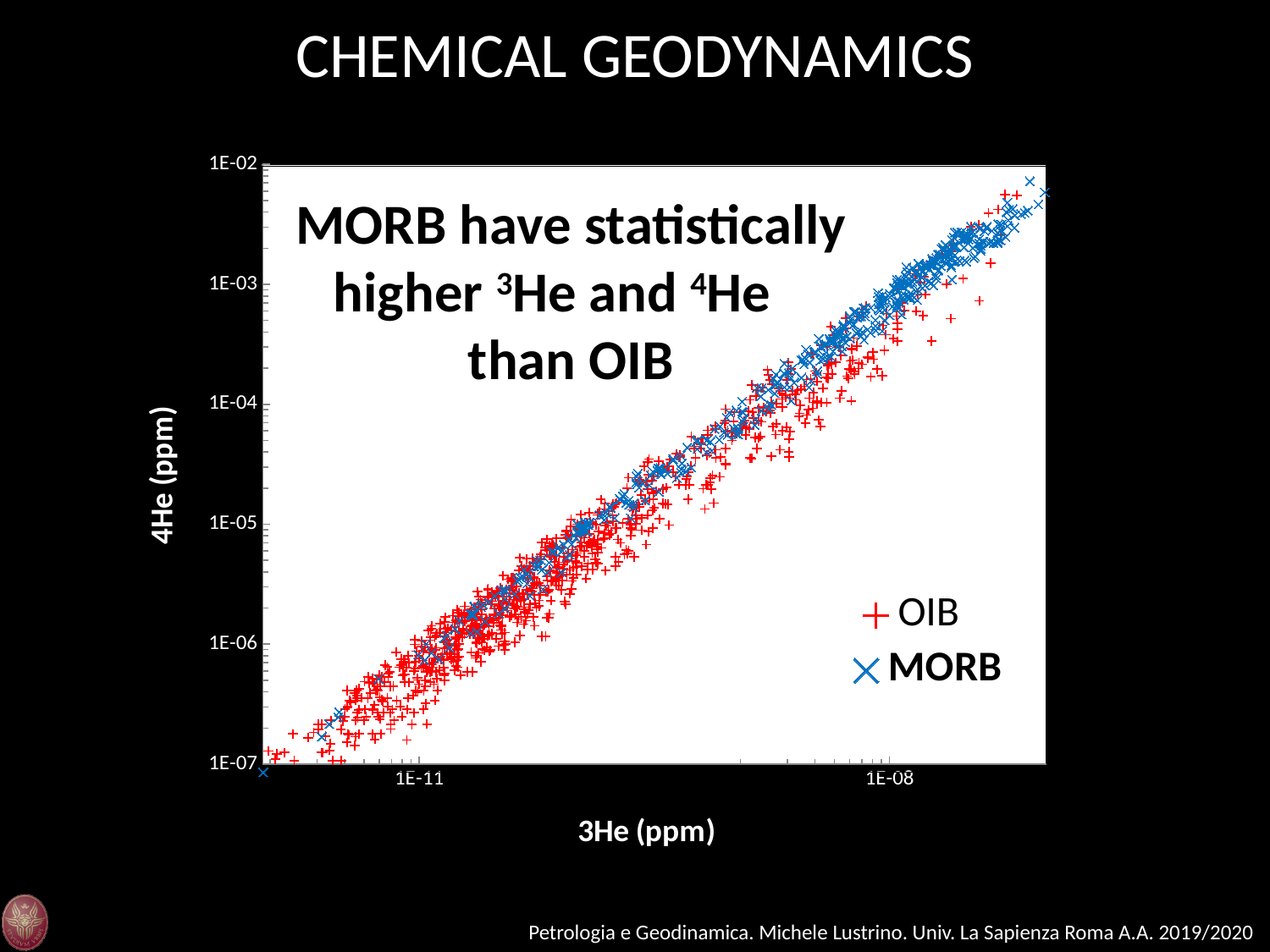
How many series does the legend list? 2 According to the slide, which group has statistically higher 3He and 4He, MORB or OIB? MORB Which series reaches the highest 4He (ppm) values at the top right of the plot, OIB or MORB? MORB What is the label of the x axis? 3He (ppm) As 3He (ppm) increases along the x axis, do the 4He (ppm) values rise or fall? rise Which two series are listed in the legend? OIB and MORB What kind of chart is shown on the slide? scatter plot